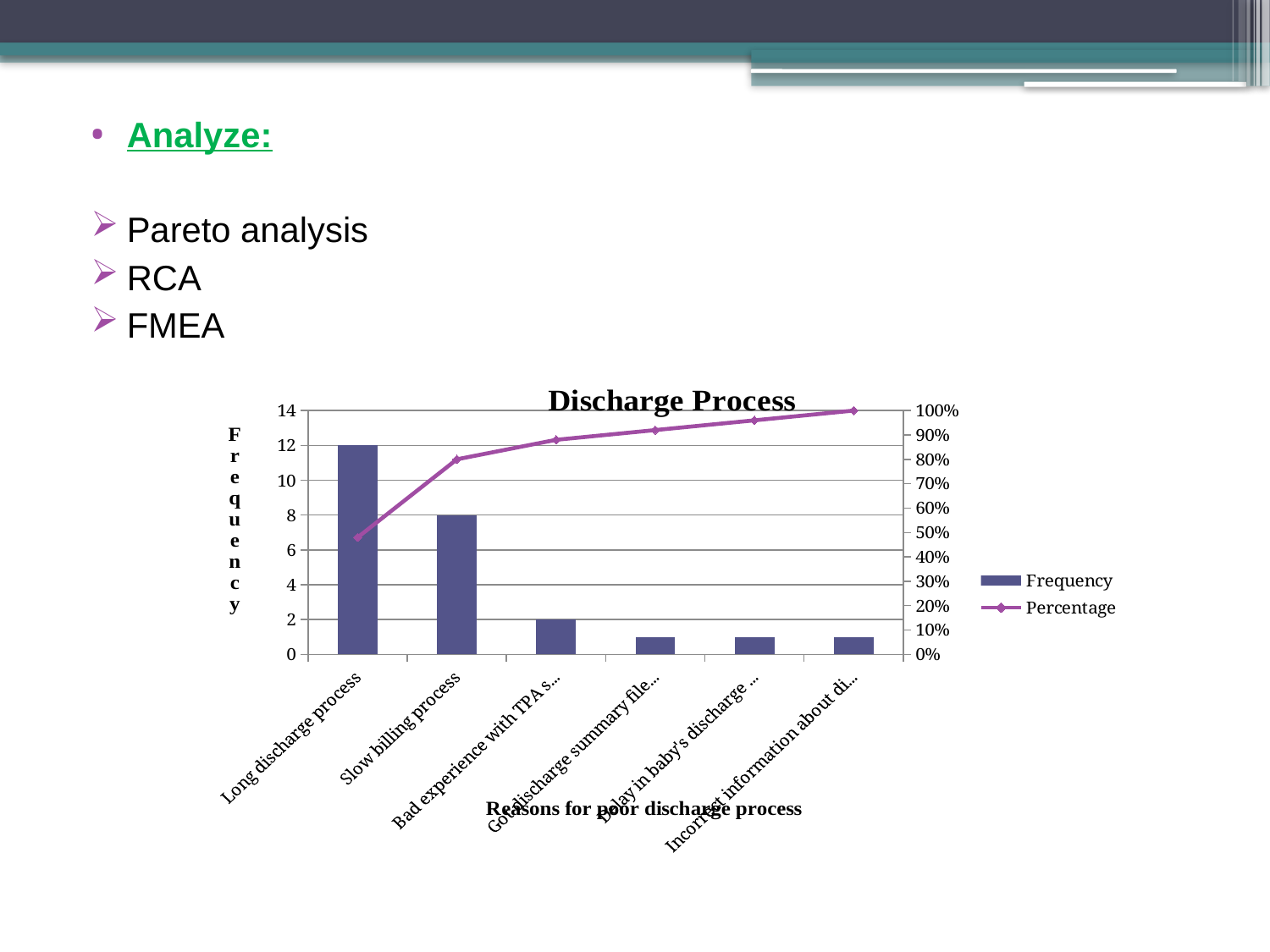
What is the frequency for Bad experience with TPA? 2 What is the frequency for Slow billing process? 8 What is the frequency for Long discharge process in the Discharge Process chart? 12 What is the difference in frequency between Long discharge process and Slow billing process? 4 What kind of chart is shown on the slide? Bar chart with a line (Pareto chart) How many series does the legend list? 2 Which has a higher frequency, Slow billing process or Bad experience with TPA? Slow billing process How many reasons are shown on the x axis of the chart? 6 What is the cumulative percentage at the last category, Incorrect information about di...? 100% Which reason has the highest frequency? Long discharge process Do the frequency bars rise or fall from left to right along the x axis? fall Is the percentage value for Long discharge process greater or less than 60%? less